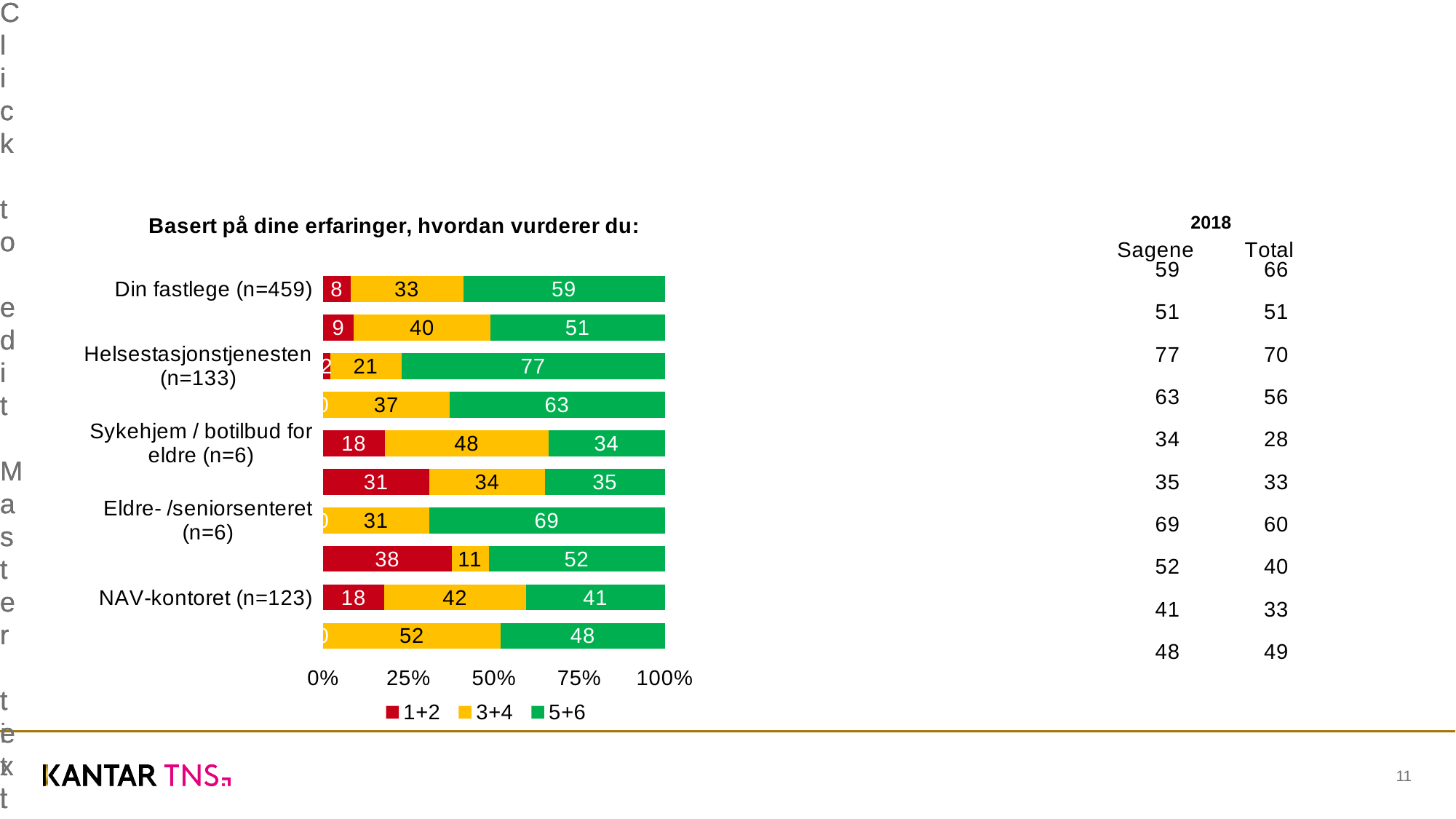
How many series does the legend list? 3 What is the difference between the 5+6 value for Din fastlege (n=459) and the 5+6 value for NAV-kontoret (n=123)? 18 Among the labelled categories, which has the lowest 5+6 value? Sykehjem / botilbud for eldre (n=6) What is the 5+6 value for the bar labelled Din fastlege (n=459)? 59 What is the title of the chart? Basert på dine erfaringer, hvordan vurderer du: What is the 1+2 value for the bar labelled NAV-kontoret (n=123)? 18 What is the 5+6 value for the bar labelled Helsestasjonstjenesten (n=133)? 77 What are the legend entries of the chart? 1+2, 3+4, 5+6 What kind of chart is shown on the slide? Stacked bar chart What is the 3+4 value for the bar labelled Din fastlege (n=459)? 33 Among the labelled categories, which has the highest 5+6 value? Helsestasjonstjenesten (n=133) What is the 1+2 value for the bar labelled Sykehjem / botilbud for eldre (n=6)? 18